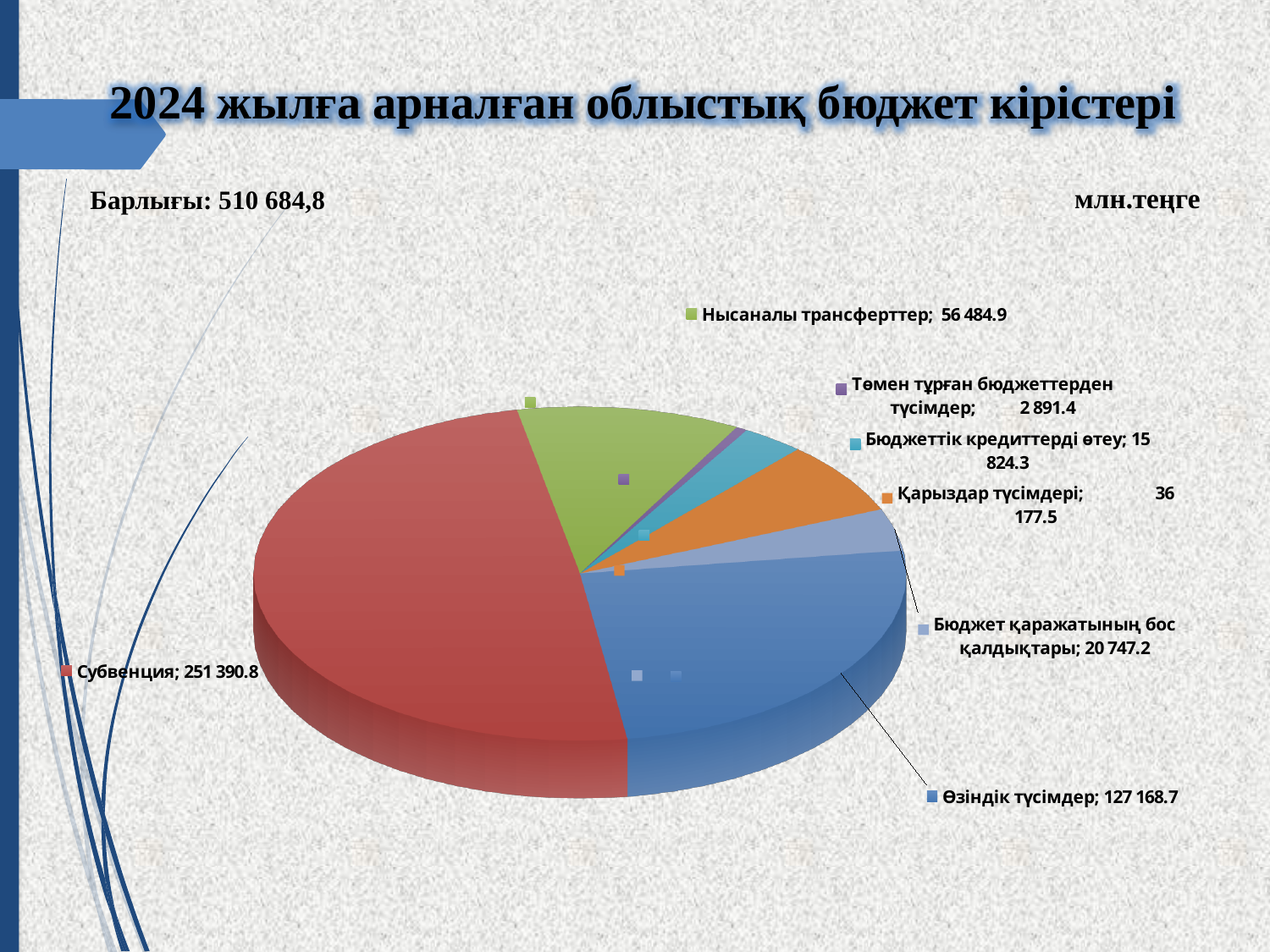
Which category has the largest slice of the pie? Субвенция What total (Барлығы) is stated on the slide? 510 684,8 How many categories are shown in the pie chart? 7 What is the value for Өзіндік түсімдер? 127 168.7 What is the value for Нысаналы трансферттер? 56 484.9 What is the value for Субвенция? 251 390.8 Which is larger, Қарыздар түсімдері or Бюджеттік кредиттерді өтеу? Қарыздар түсімдері Which category has the smallest slice of the pie? Төмен тұрған бюджеттерден түсімдер What is the difference between the values for Субвенция and Өзіндік түсімдер? 124 222.1 What is the value for Төмен тұрған бюджеттерден түсімдер? 2 891.4 What is the value for Бюджет қаражатының бос қалдықтары? 20 747.2 What kind of chart is shown on the slide? pie chart